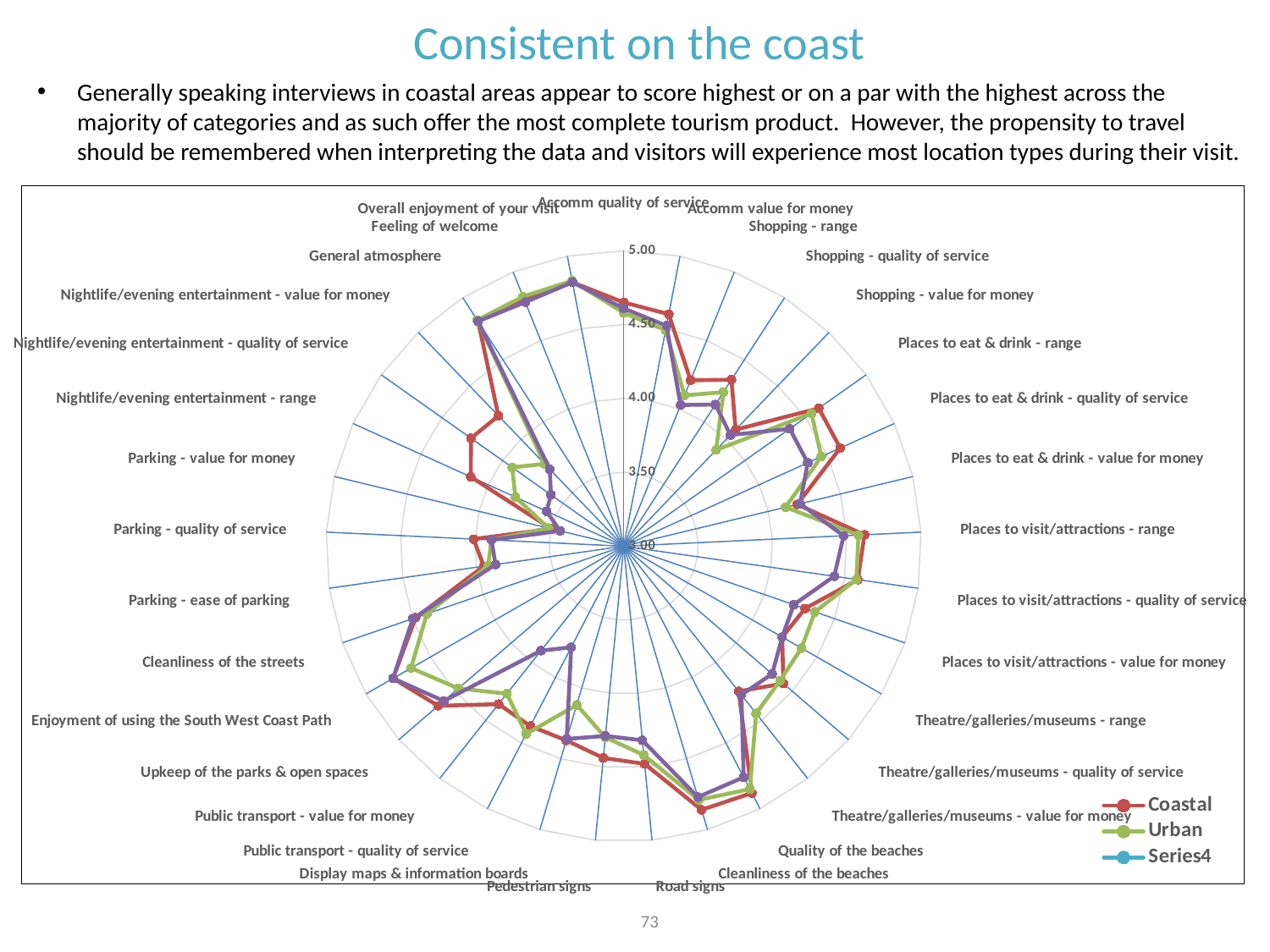
What kind of chart is shown on the slide? Radar chart Which series are listed in the chart legend? Coastal, Urban, Series4 How many categories (spokes) does the radar chart have? 33 Is the Coastal value for Overall enjoyment of your visit greater or less than 4.50? greater What colour is used for the Coastal series in the chart? Red Is the Urban value for Parking - quality of service greater or less than 4.00? less Is the Coastal value for Places to visit/attractions - range greater or less than 4.00? greater How many series does the chart legend list? 3